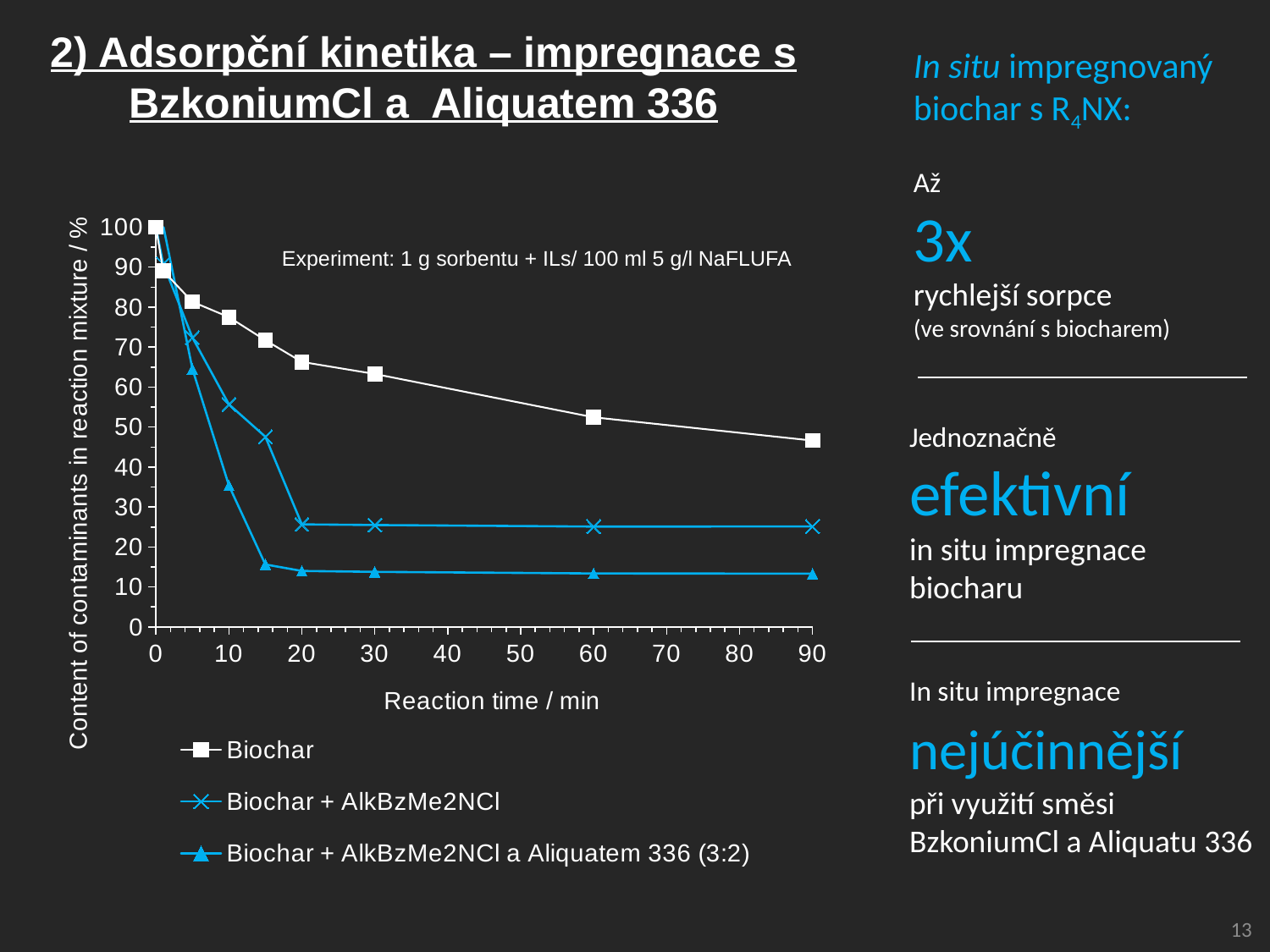
How many series does the legend list? 3 What kind of chart is shown on the slide? line chart What is the title of the x axis? Reaction time / min Which series has the lowest value at 90 min? Biochar + AlkBzMe2NCl a Aliquatem 336 (3:2) Is the value for Biochar at 30 min greater or less than 60? greater At 60 min, which is larger: the value for Biochar or the value for Biochar + AlkBzMe2NCl? Biochar Which series has the highest value at 90 min? Biochar Is the value for Biochar + AlkBzMe2NCl at 90 min greater or less than 30? less Is the value for Biochar at 90 min greater or less than 50? less What experiment description is printed inside the chart area? Experiment: 1 g sorbentu + ILs/ 100 ml 5 g/l NaFLUFA Do the values for Biochar rise or fall as reaction time increases? fall